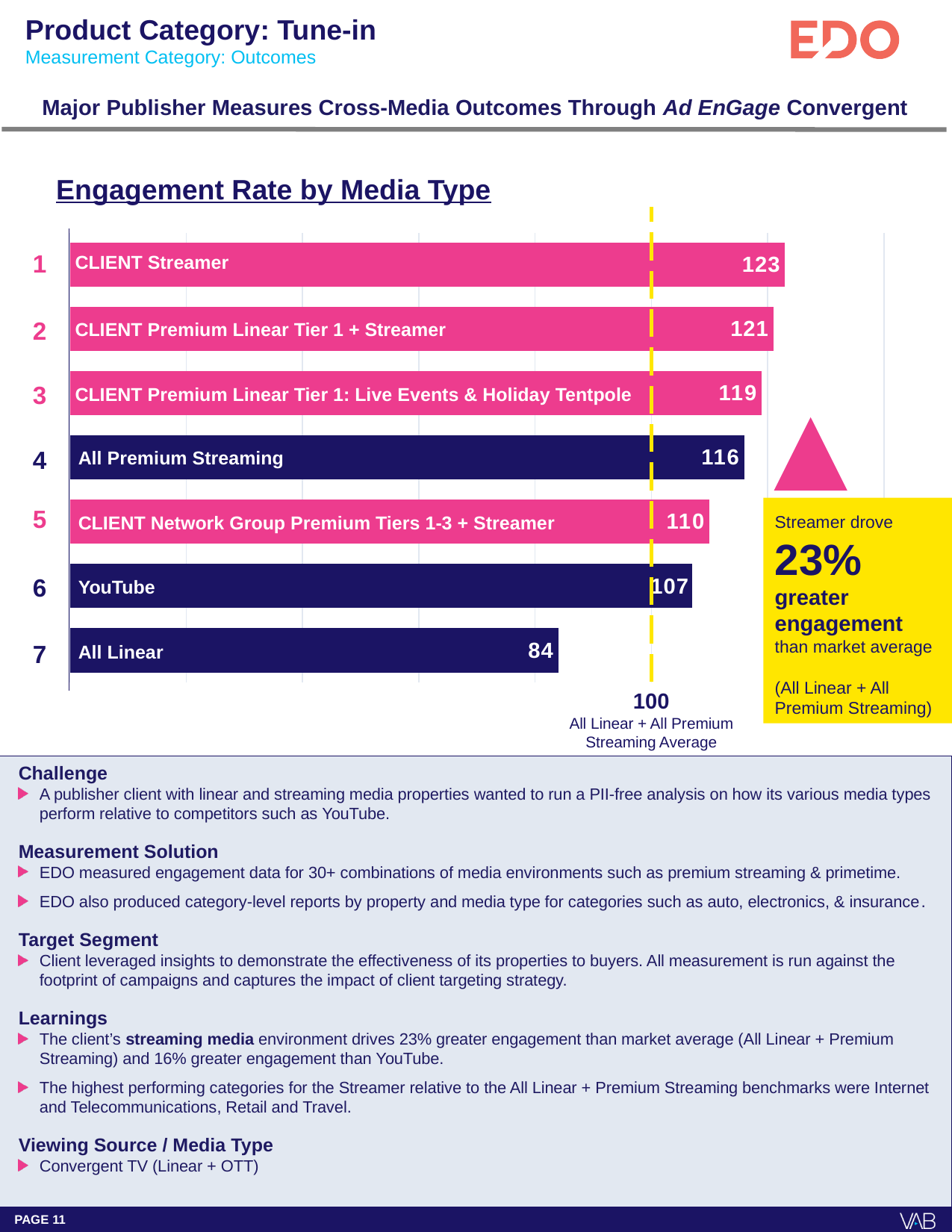
Is the engagement rate for All Linear greater or less than 100? less Which media type has the highest engagement rate? CLIENT Streamer What value does the dashed vertical line in the chart mark? 100 What is the engagement rate for YouTube? 107 What is the difference in engagement rate between CLIENT Streamer and All Linear? 39 How many media types are shown in the chart? 7 Which has a higher engagement rate, CLIENT Network Group Premium Tiers 1-3 + Streamer or YouTube? CLIENT Network Group Premium Tiers 1-3 + Streamer What is the engagement rate for All Premium Streaming? 116 What kind of chart is used to show Engagement Rate by Media Type? bar chart What is the difference in engagement rate between All Premium Streaming and YouTube? 9 Which media type has the lowest engagement rate? All Linear What is the engagement rate for CLIENT Streamer? 123